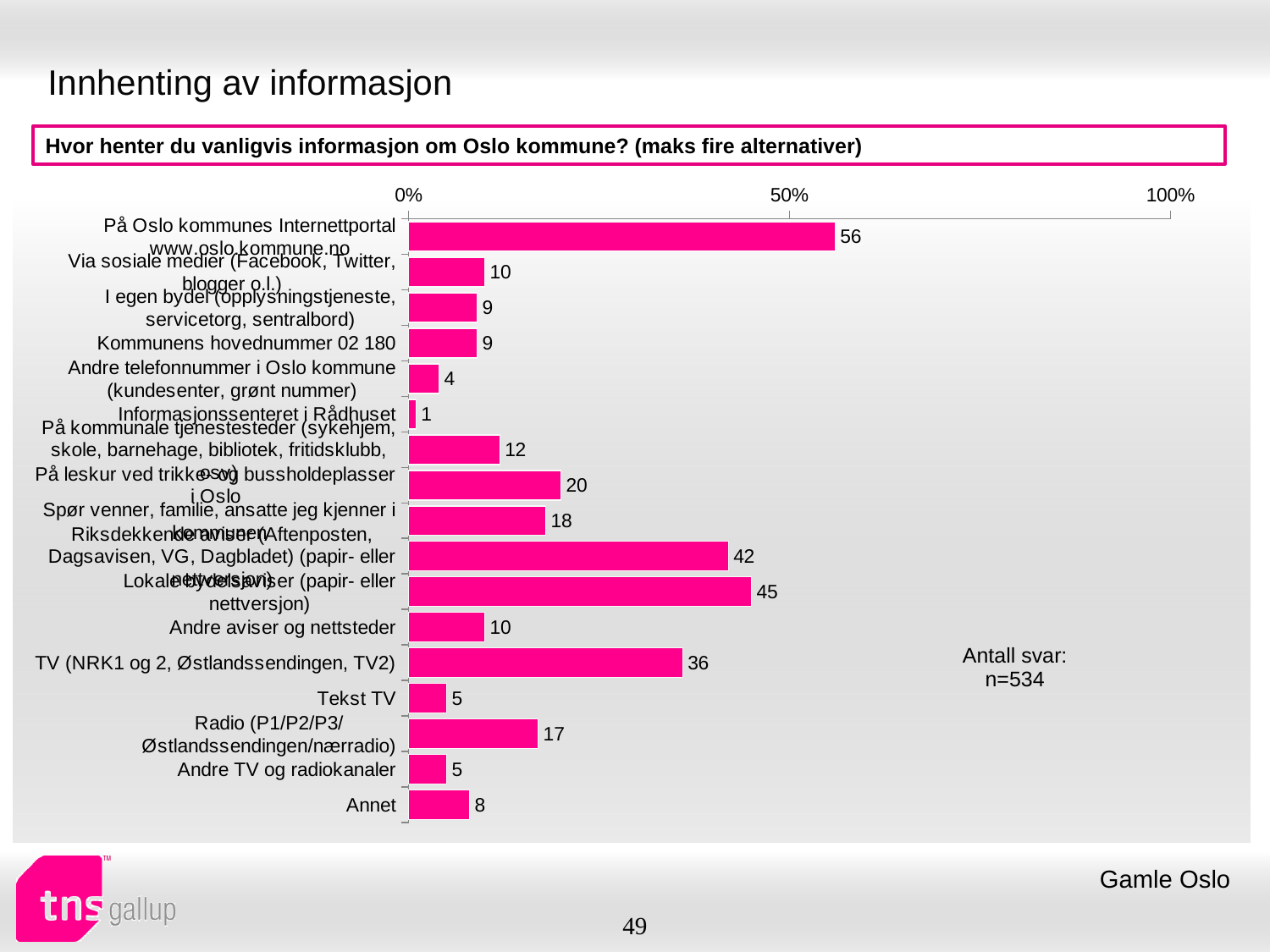
What type of chart is shown on the slide? Bar chart Which category has the highest value? På Oslo kommunes Internettportal www.oslo.kommune.no What value is shown for "TV (NRK1 og 2, Østlandssendingen, TV2)"? 36 How many categories are shown in the chart? 17 How many respondents (n) does the slide report for the chart? n=534 What is the difference between the values for "Lokale bydelsaviser (papir- eller nettversjon)" and "Andre aviser og nettsteder"? 35 Is the value for "På Oslo kommunes Internettportal www.oslo.kommune.no" greater or less than 50%? greater What value is shown for "Kommunens hovednummer 02 180"? 9 Which is larger: the value for "Andre telefonnummer i Oslo kommune (kundesenter, grønt nummer)" or the value for "Andre TV og radiokanaler"? Andre TV og radiokanaler What value is shown for "Annet"? 8 Which category has the lowest value? Informasjonssenteret i Rådhuset What value is shown for "Tekst TV"? 5